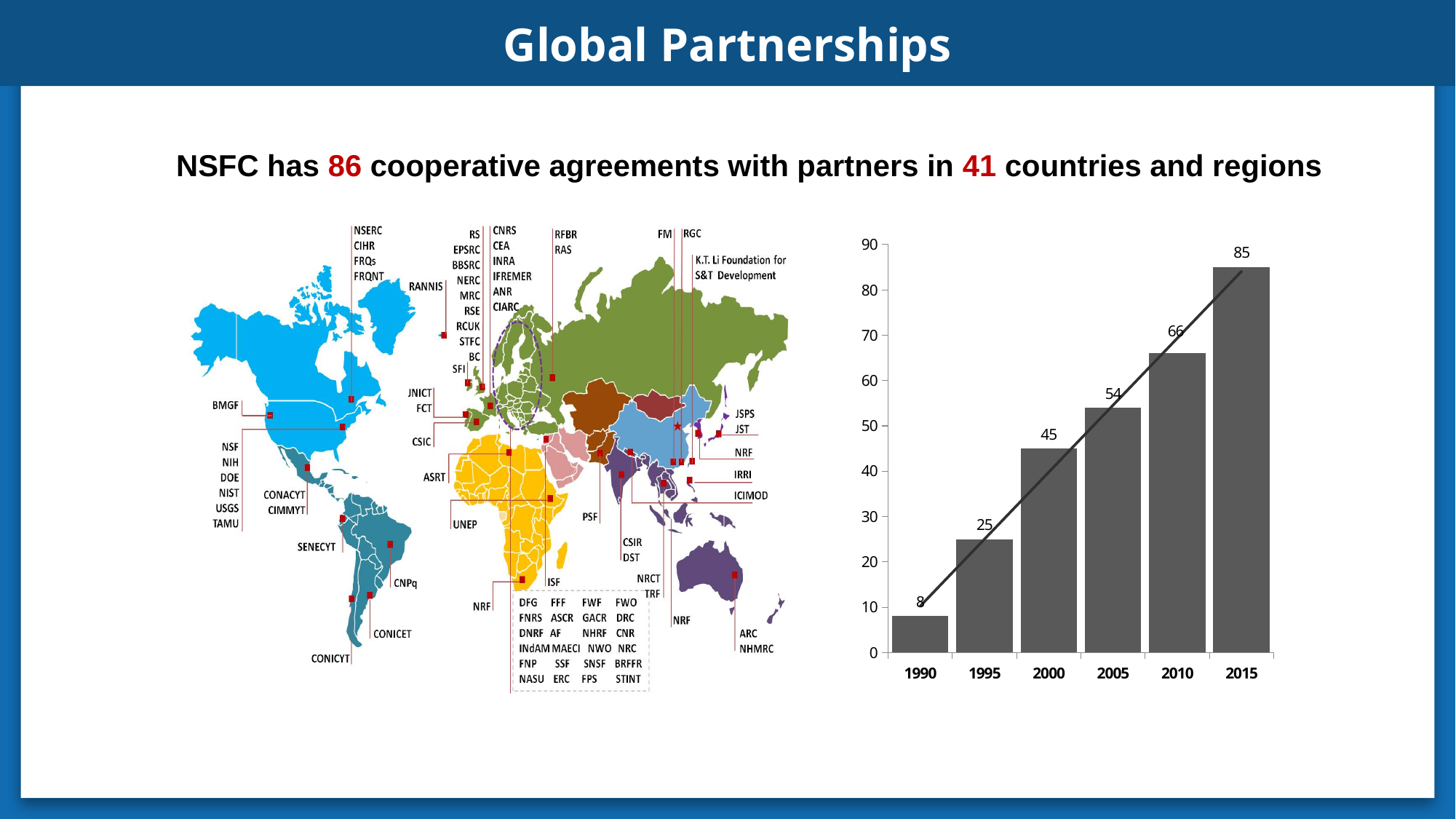
Which is larger in the bar chart, the value for 2005 or the value for 2000? 2005 What is the difference between the values for 2015 and 1990 in the bar chart? 77 Do the values in the bar chart rise or fall from 1990 to 2015? rise What is the value for 2000 in the bar chart? 45 What kind of chart is shown on the right side of the slide? bar chart How many years are shown on the x axis of the bar chart? 6 What is the value for 1990 in the bar chart? 8 What is the value for 2005 in the bar chart? 54 Which year has the lowest value in the bar chart? 1990 What is the difference between the values for 2010 and 1995 in the bar chart? 41 What is the value for 2015 in the bar chart? 85 Which year has the highest value in the bar chart? 2015